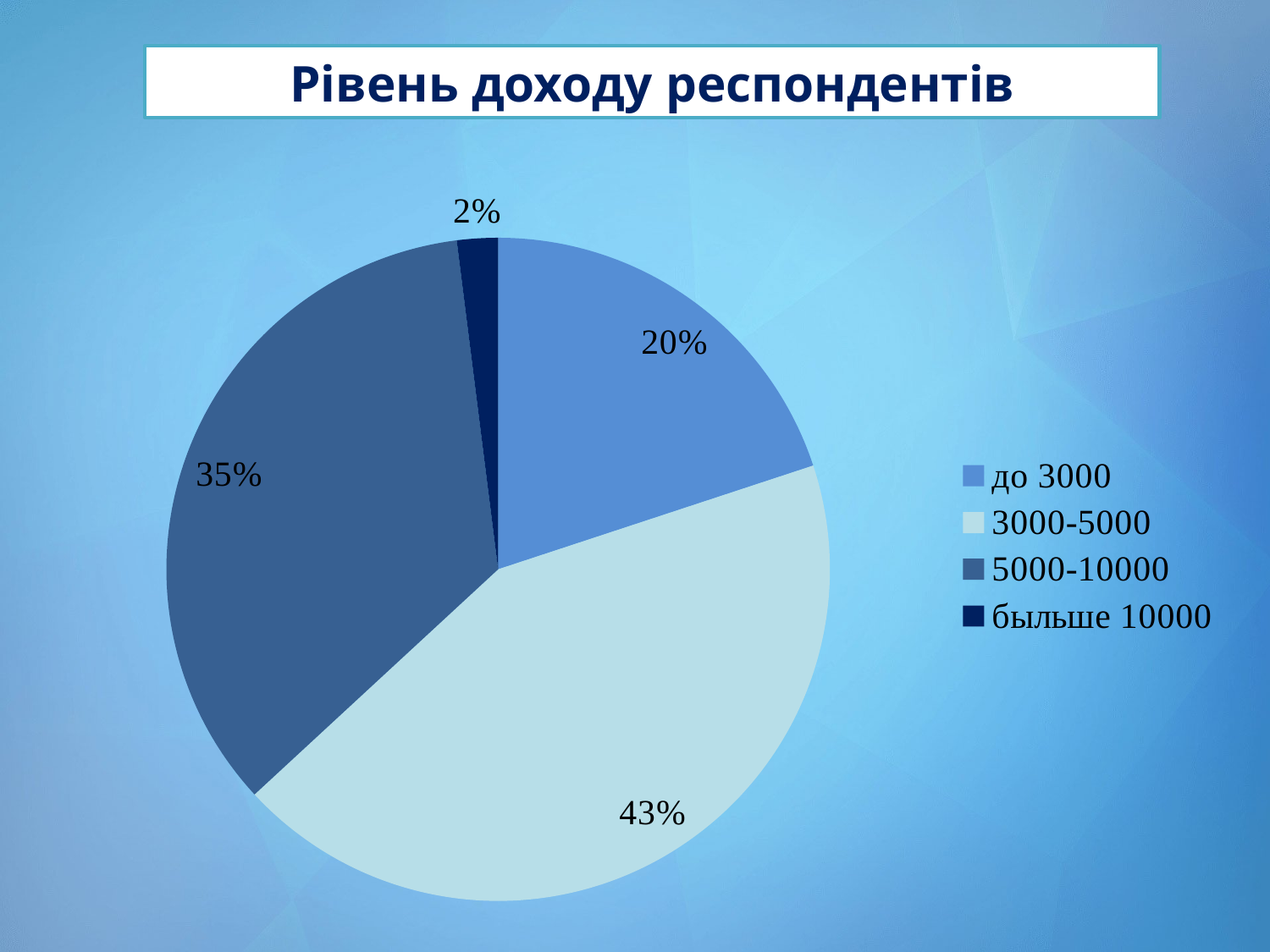
What is the combined share of the до 3000 and 3000-5000 categories? 63% Which income category has the smallest share of respondents? быльше 10000 Which category has a larger share: до 3000 or 5000-10000? 5000-10000 Which income category has the largest share of respondents? 3000-5000 What share of respondents have an income of 5000-10000? 35% What is the title of the chart? Рівень доходу респондентів What is the difference in percentage points between the 3000-5000 and 5000-10000 categories? 8 What kind of chart is shown on the slide? pie chart How many income categories are shown in the pie chart? 4 What share of respondents have an income of быльше 10000? 2% What share of respondents have an income of до 3000? 20% What share of respondents have an income of 3000-5000? 43%